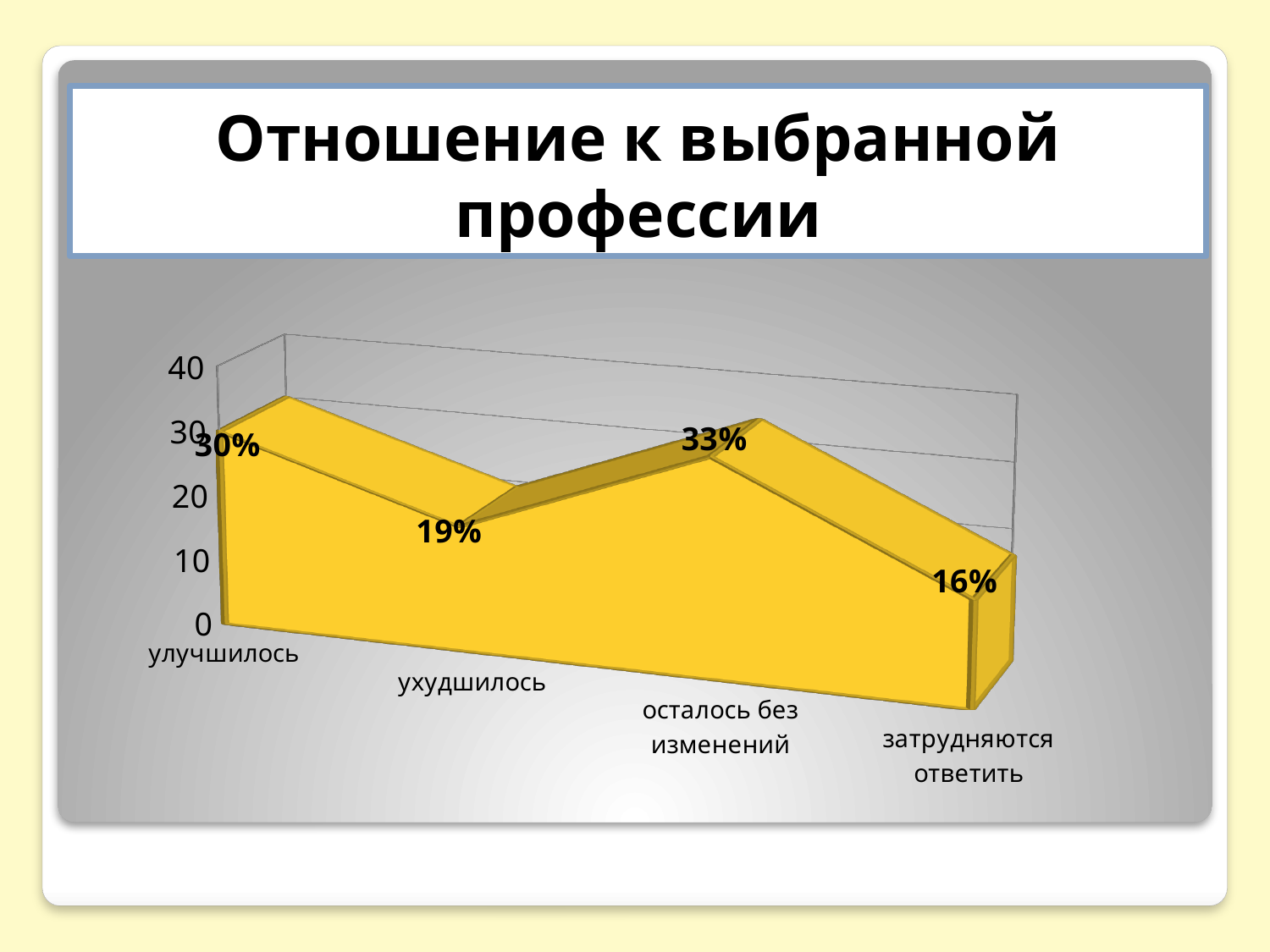
What is the value for затрудняются ответить? 16% What is the value for улучшилось? 30% What kind of chart is shown on the slide? area chart Which is larger, the value for улучшилось or the value for затрудняются ответить? улучшилось Is the value for ухудшилось greater or less than 20? less What is the value for ухудшилось? 19% What is the title of the slide? Отношение к выбранной профессии What is the difference between the values for осталось без изменений and ухудшилось? 14% Which category has the lowest value? затрудняются ответить Which category has the highest value? осталось без изменений How many categories are shown on the x axis? 4 What is the value for осталось без изменений? 33%